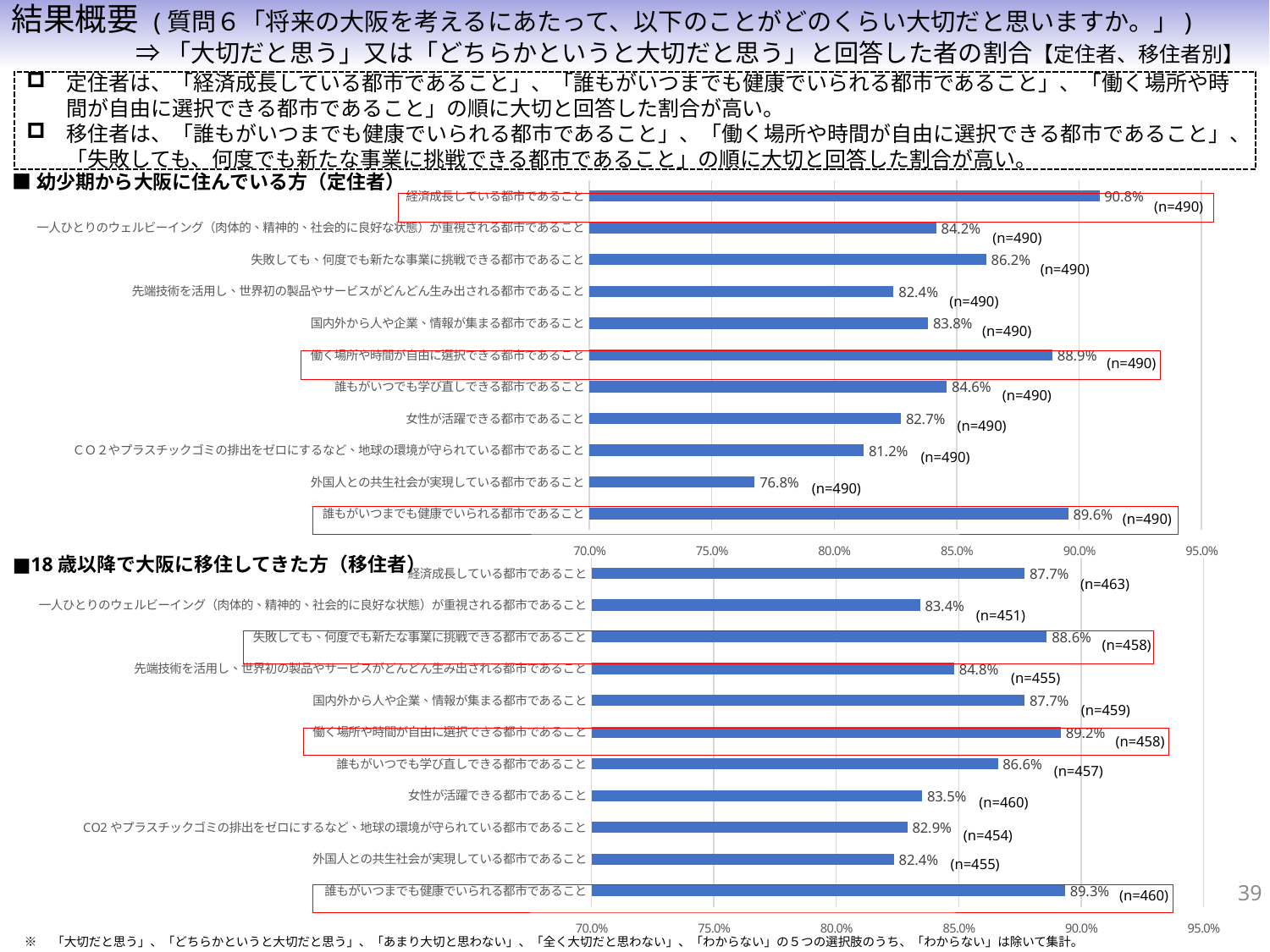
In the bottom chart (移住者), which is larger: 失敗しても、何度でも新たな事業に挑戦できる都市であること or 女性が活躍できる都市であること? 失敗しても、何度でも新たな事業に挑戦できる都市であること In the top chart (定住者), what is the value for ＣＯ2やプラスチックゴミの排出をゼロにするなど、地球の環境が守られている都市であること? 81.2% In the bottom chart (18歳以降で大阪に移住してきた方（移住者）), what is the value for 働く場所や時間が自由に選択できる都市であること? 89.2% What kind of chart is used on this slide? Bar chart In the bottom chart (移住者), which category has the highest value? 誰もがいつまでも健康でいられる都市であること In the top chart (定住者), what is the difference between 経済成長している都市であること and 外国人との共生社会が実現している都市であること? 14.0% In the bottom chart (移住者), which category has the lowest value? 外国人との共生社会が実現している都市であること In the top chart (定住者), which category has the lowest value? 外国人との共生社会が実現している都市であること How many categories are shown in the top chart (定住者)? 11 In the bottom chart (移住者), what is the difference between 誰もがいつまでも健康でいられる都市であること and 経済成長している都市であること? 1.6% In the top chart (幼少期から大阪に住んでいる方（定住者）), what is the value for 経済成長している都市であること? 90.8% In the top chart (定住者), which category has the highest value? 経済成長している都市であること